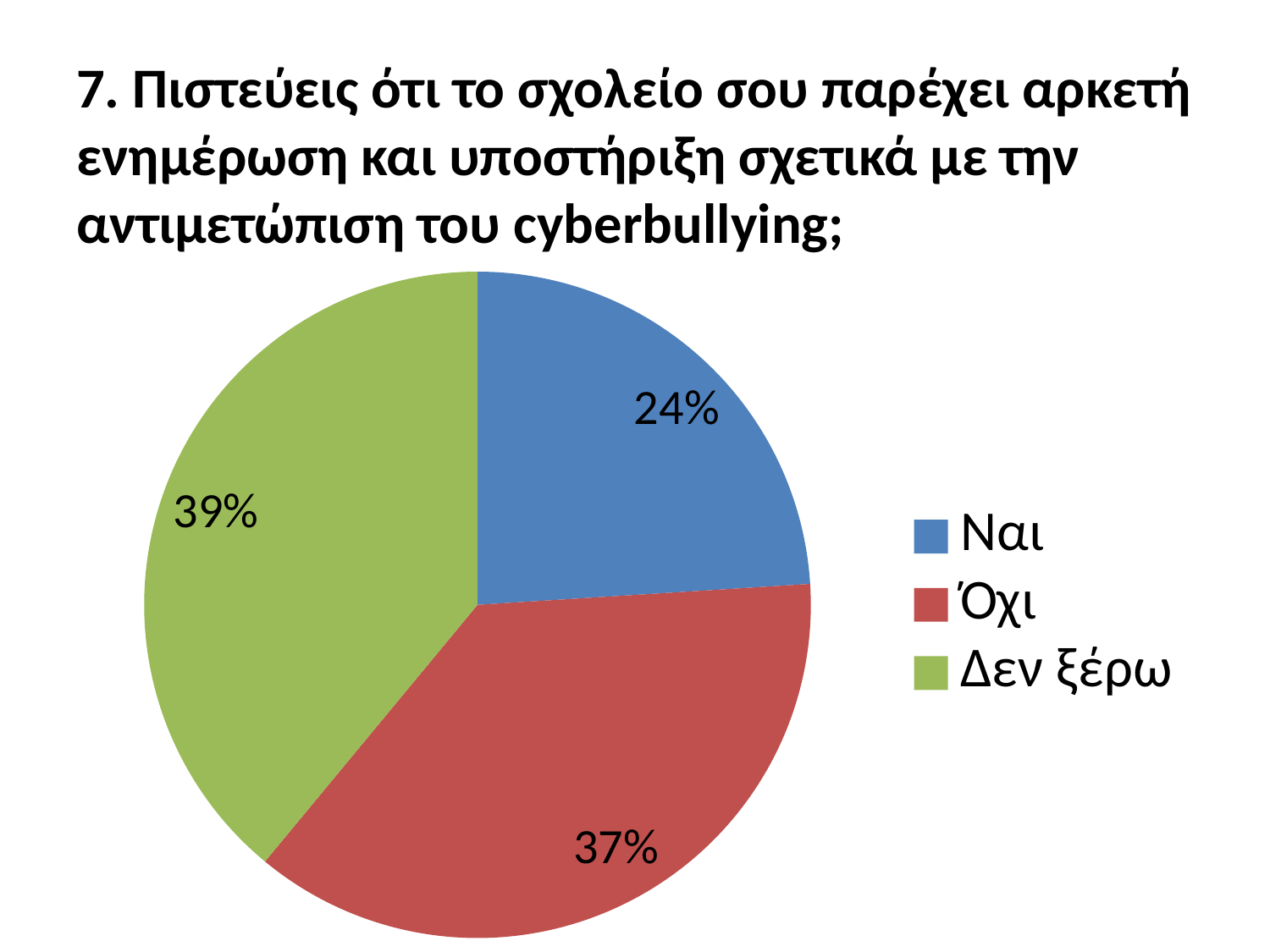
What percentage of respondents answered Ναι? 24% What kind of chart is shown on the slide? Pie chart What colour is the slice for Όχι? Red Which answer has the largest share of the pie? Δεν ξέρω How many slices does the pie chart have? 3 What percentage of respondents answered Δεν ξέρω? 39% Which answer has the smallest share of the pie? Ναι What is the difference in percentage points between Δεν ξέρω and Ναι? 15 What percentage of respondents answered Όχι? 37% What is the difference in percentage points between Όχι and Ναι? 13 Which legend entry is shown in green? Δεν ξέρω Which is larger, the share for Όχι or the share for Ναι? Όχι